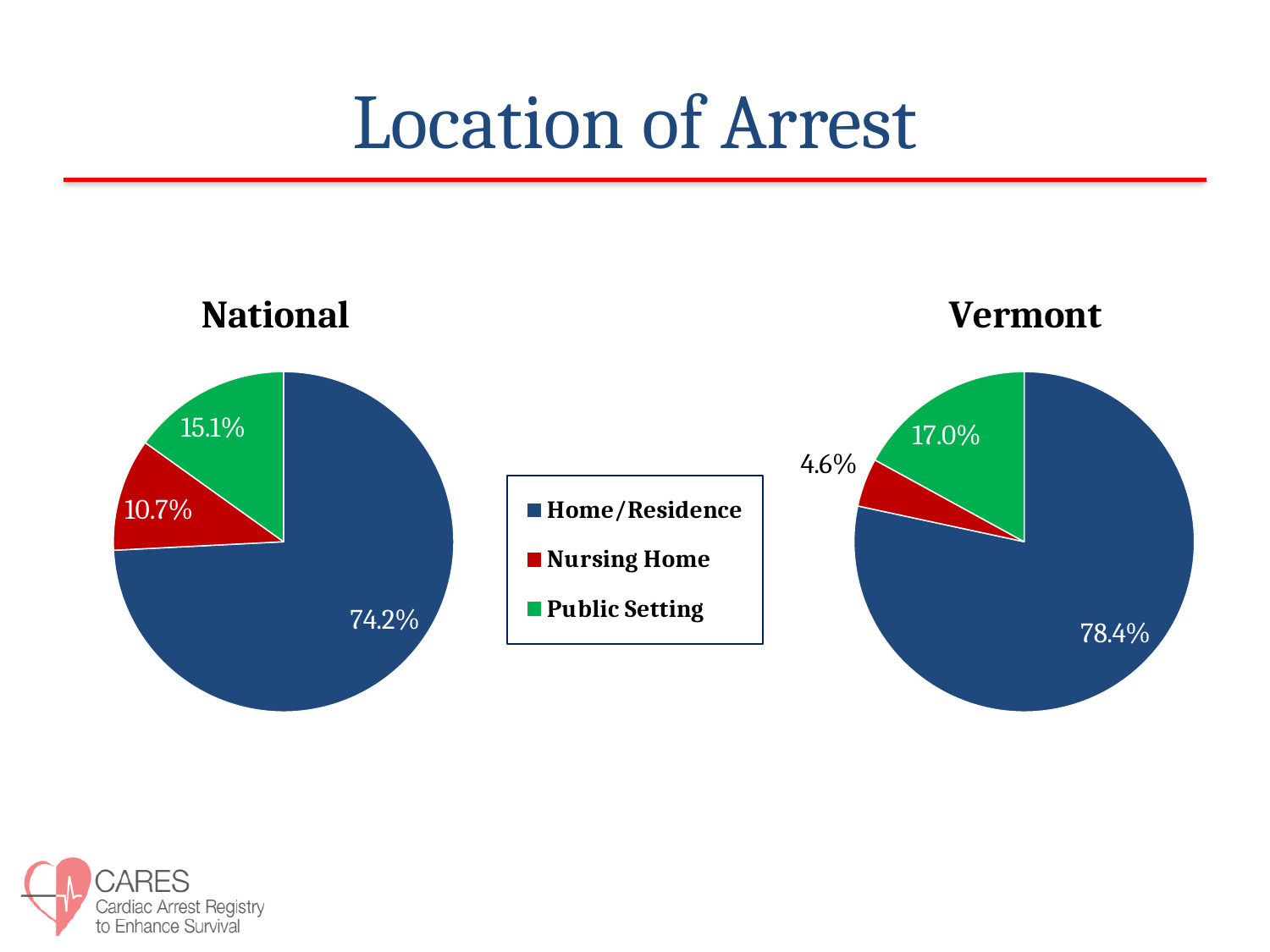
What is the difference between the Home/Residence share in the Vermont chart and the Home/Residence share in the National chart? 4.2% Which is larger: the Nursing Home share in the National chart or the Nursing Home share in the Vermont chart? National In the Vermont pie chart, what share of arrests occurred in a Public Setting? 17.0% In the National pie chart, which location has the smallest share? Nursing Home What is the difference between the Public Setting share and the Nursing Home share in the National chart? 4.4% In the National pie chart, what share of arrests occurred in a Nursing Home? 10.7% In the National pie chart, what share of arrests occurred at Home/Residence? 74.2% In the Vermont pie chart, what share of arrests occurred in a Nursing Home? 4.6% Which colour represents Public Setting in the pie charts? Green In the Vermont pie chart, which location has the largest share? Home/Residence What type of chart is used on this slide? Pie chart How many categories does the legend list? 3